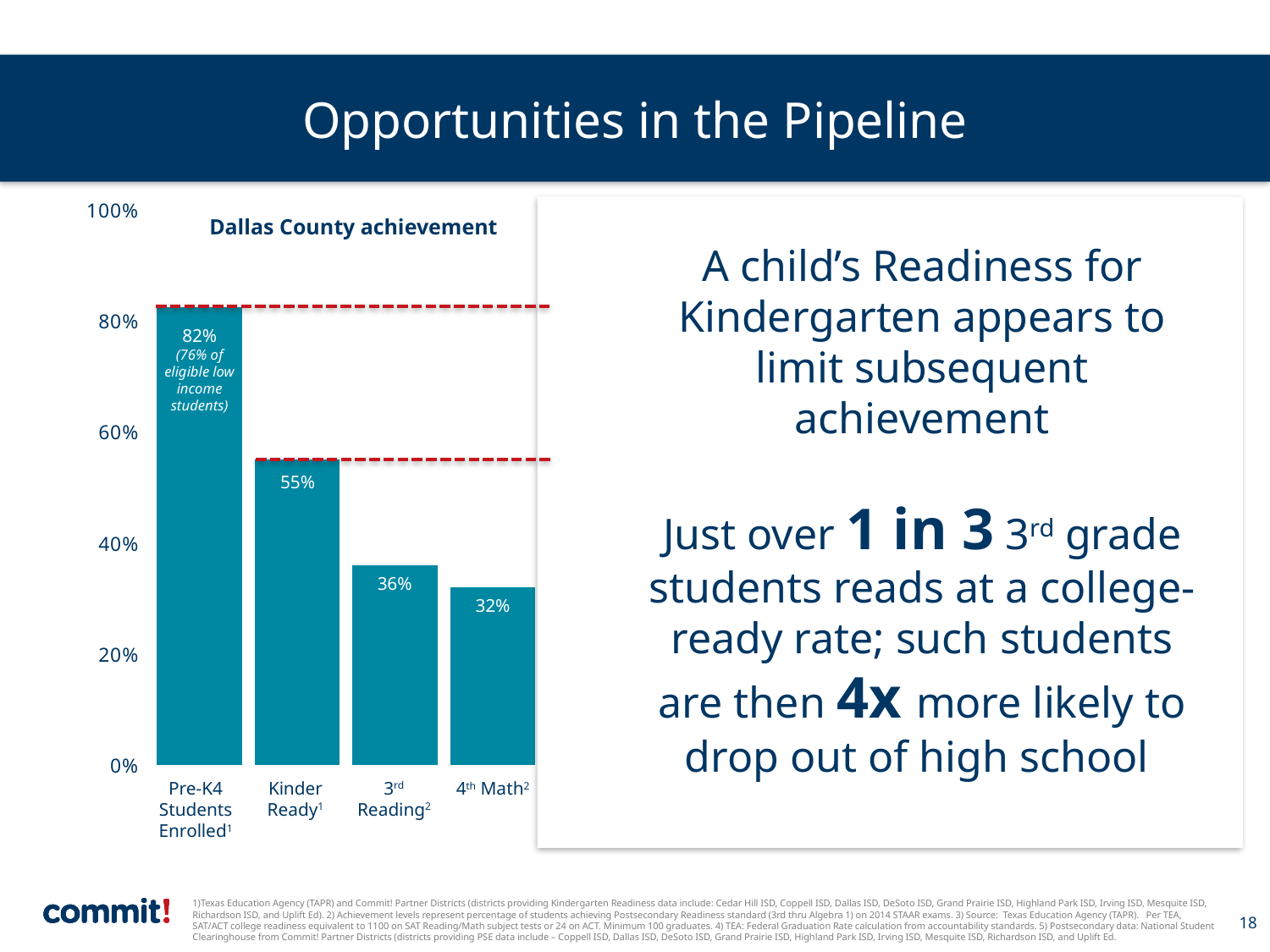
Which is larger, the value for Kinder Ready or the value for 3rd Reading? Kinder Ready What is the value for Pre-K4 Students Enrolled? 82% Which category has the lowest value? 4th Math What is the value for 4th Math? 32% What kind of chart is shown on the slide? Bar chart What is the value for 3rd Reading? 36% How many categories are shown in the chart? 4 What is the difference between the 3rd Reading value and the 4th Math value? 4% What is the title of the chart? Dallas County achievement What is the value for Kinder Ready? 55% Which category has the highest value? Pre-K4 Students Enrolled What is the difference between the Pre-K4 Students Enrolled value and the Kinder Ready value? 27%